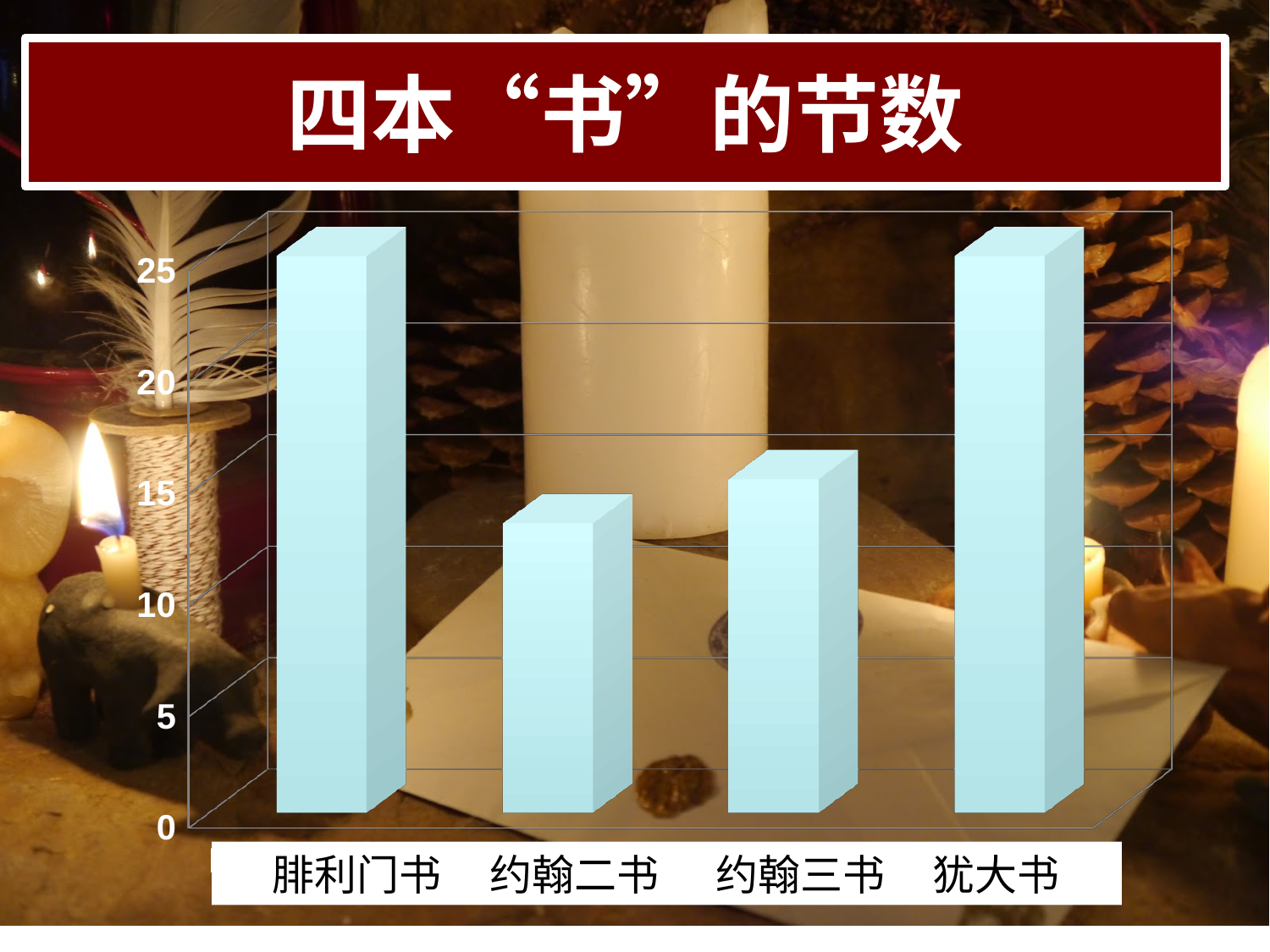
Is the value for 约翰三书 greater or less than 10? greater Is the value for 腓利门书 greater or less than 20? greater Is the value for 犹大书 greater or less than 20? greater What kind of chart is shown on the slide? bar chart Which book has the lowest bar in the chart? 约翰二书 What is the title of the chart? 四本“书”的节数 Which is larger, the value for 约翰二书 or the value for 约翰三书? 约翰三书 How many categories (books) are shown on the x axis of the chart? 4 Which is larger, the value for 腓利门书 or the value for 约翰二书? 腓利门书 Which is larger, the value for 犹大书 or the value for 约翰三书? 犹大书